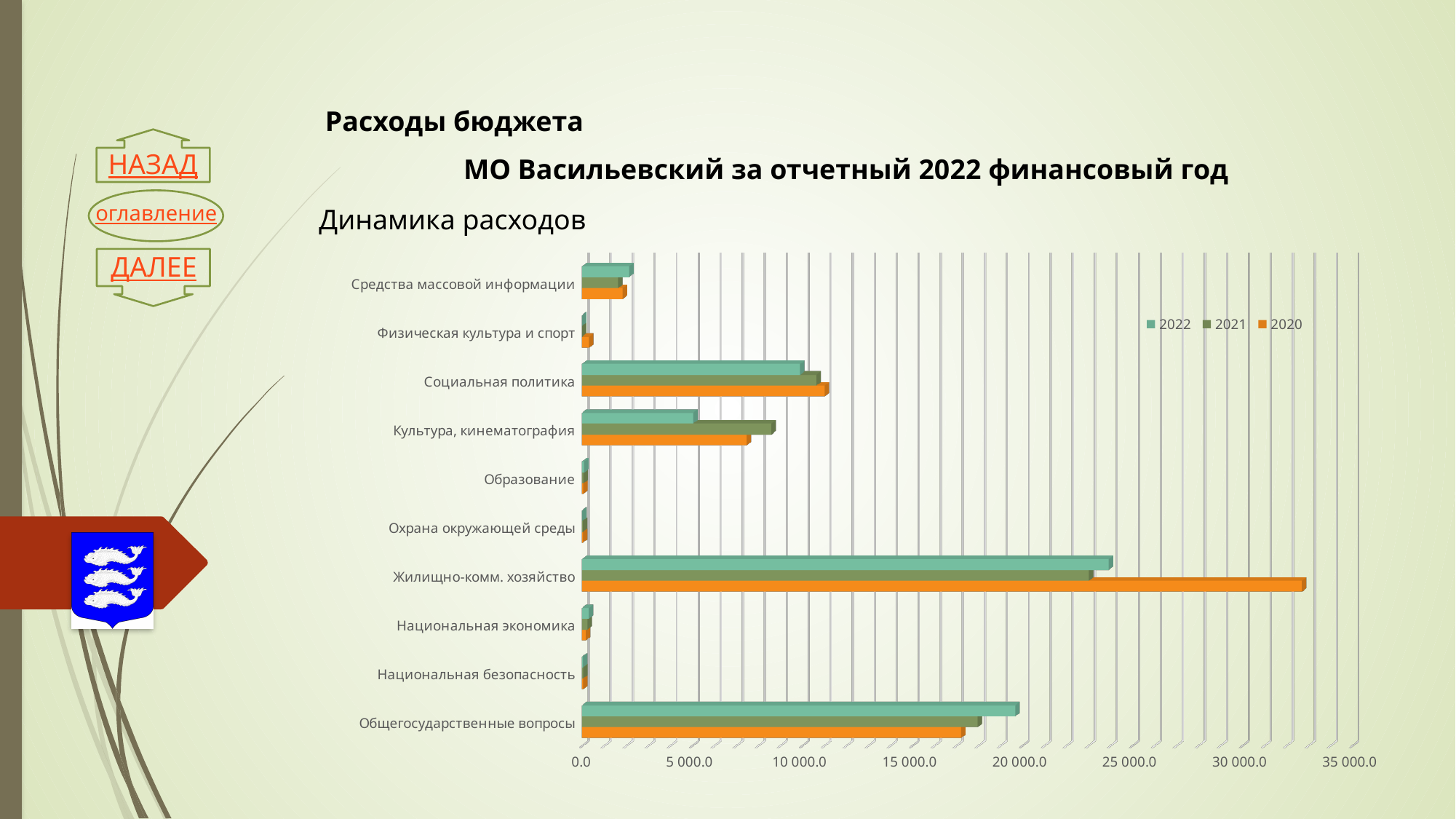
What kind of chart is shown on the slide? bar chart Is the 2020 value for Жилищно-комм. хозяйство greater or less than 30 000.0? greater For Жилищно-комм. хозяйство, which year has the larger value, 2020 or 2022? 2020 Is the 2022 value for Жилищно-комм. хозяйство greater or less than 25 000.0? less For Общегосударственные вопросы, which year has the larger value, 2022 or 2020? 2022 Which category has the highest value for 2022? Жилищно-комм. хозяйство Which category has the highest value for 2020? Жилищно-комм. хозяйство How many expenditure categories are shown on the chart? 10 Is the 2021 value for Культура, кинематография greater or less than 10 000.0? less How many series does the chart legend list? 3 Which colour represents the 2020 series in the legend? orange